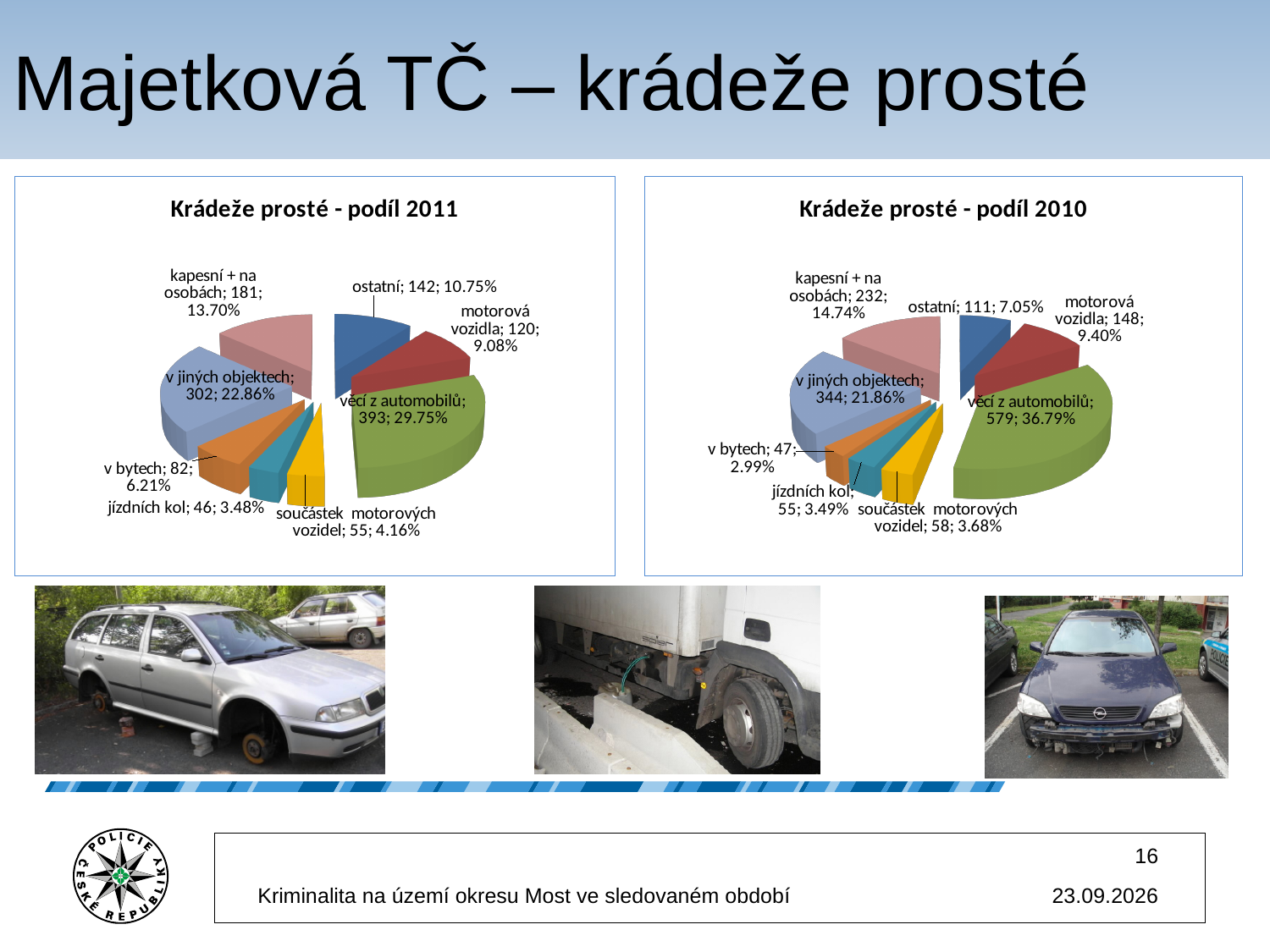
What is the title of the chart on the right side of the slide? Krádeže prosté - podíl 2010 In the chart 'Krádeže prosté - podíl 2011', which category has the smallest slice? jízdních kol In the chart 'Krádeže prosté - podíl 2011', what is the difference between the values for 'v jiných objektech' and 'kapesní + na osobách'? 121 In the chart 'Krádeže prosté - podíl 2010', what percentage share does 'kapesní + na osobách' have? 14.74% In the chart 'Krádeže prosté - podíl 2010', what is the value for 'součástek motorových vozidel'? 58 In the chart 'Krádeže prosté - podíl 2010', which category has the smallest slice? v bytech What type of chart is 'Krádeže prosté - podíl 2010'? pie chart In the chart 'Krádeže prosté - podíl 2011', what percentage share does 'jízdních kol' have? 3.48% In the chart 'Krádeže prosté - podíl 2010', which is larger: 'ostatní' or 'motorová vozidla'? motorová vozidla How many categories are shown in the chart 'Krádeže prosté - podíl 2011'? 8 In the chart 'Krádeže prosté - podíl 2011', which category has the largest slice? věcí z automobilů In the chart 'Krádeže prosté - podíl 2011', what is the value for 'věcí z automobilů'? 393